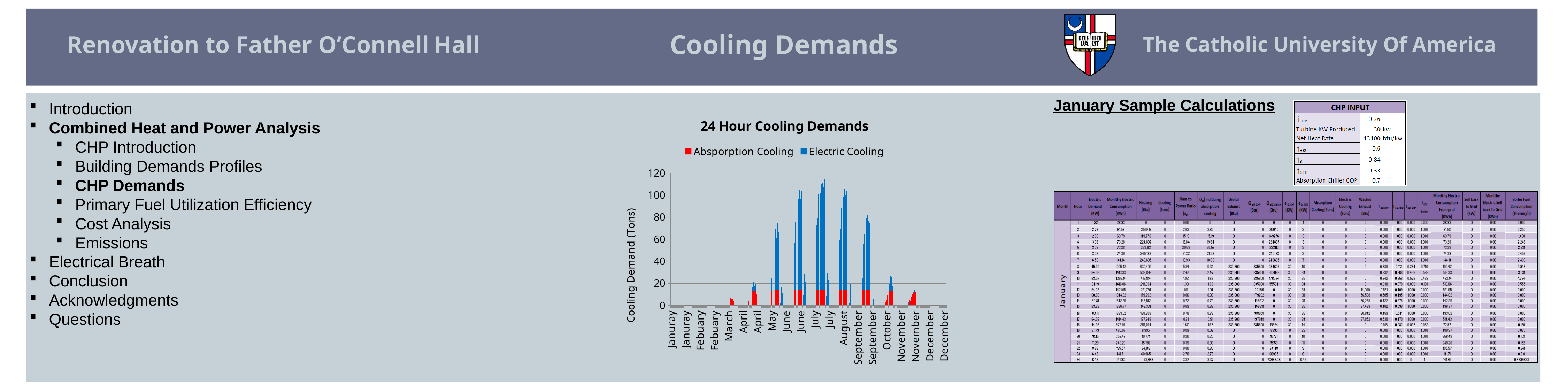
In the 24 Hour Cooling Demands chart, is the peak Electric Cooling value in October greater or less than 60? less Which colour represents Absorption Cooling in the 24 Hour Cooling Demands chart? red In the 24 Hour Cooling Demands chart, which series reaches the higher peak value, Absorption Cooling or Electric Cooling? Electric Cooling In the 24 Hour Cooling Demands chart, do the cooling demands generally rise or fall from July to December? fall What is the title of the chart on the slide? 24 Hour Cooling Demands In the 24 Hour Cooling Demands chart, which month has the highest cooling demand? July In the 24 Hour Cooling Demands chart, is the cooling demand in January greater or less than 20? less How many series does the legend of the 24 Hour Cooling Demands chart list? 2 In the 24 Hour Cooling Demands chart, is the highest Absorption Cooling value greater or less than 20? less What kind of chart is the 24 Hour Cooling Demands chart? bar chart